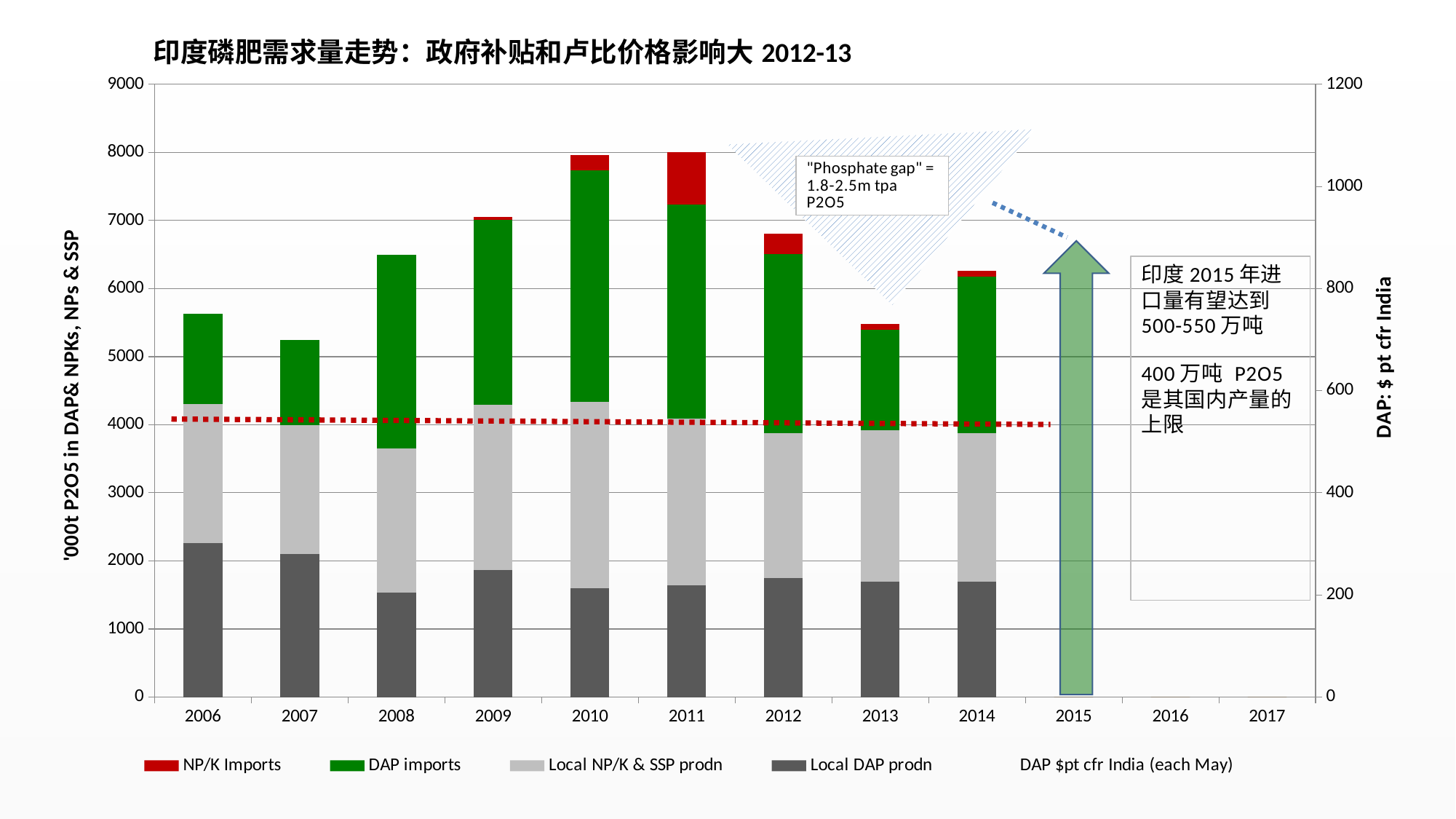
Which year has the larger total stacked bar, 2008 or 2013? 2008 What kind of chart is shown on the slide? stacked bar chart combined with a line (dotted red line for DAP price) Which year has the highest total stacked bar? 2011 Between 2011 and 2013, do the total stacked bar heights rise or fall? fall Is the Local DAP prodn value for 2006 greater or less than 2000? greater What colour represents DAP imports in the legend? green Which year has the lowest total stacked bar? 2007 Is the Local DAP prodn value for 2008 greater or less than 2000? less For how many years are stacked bars plotted? 9 How many series does the legend list? 5 Is the total stacked bar for 2011 greater or less than 7000? greater